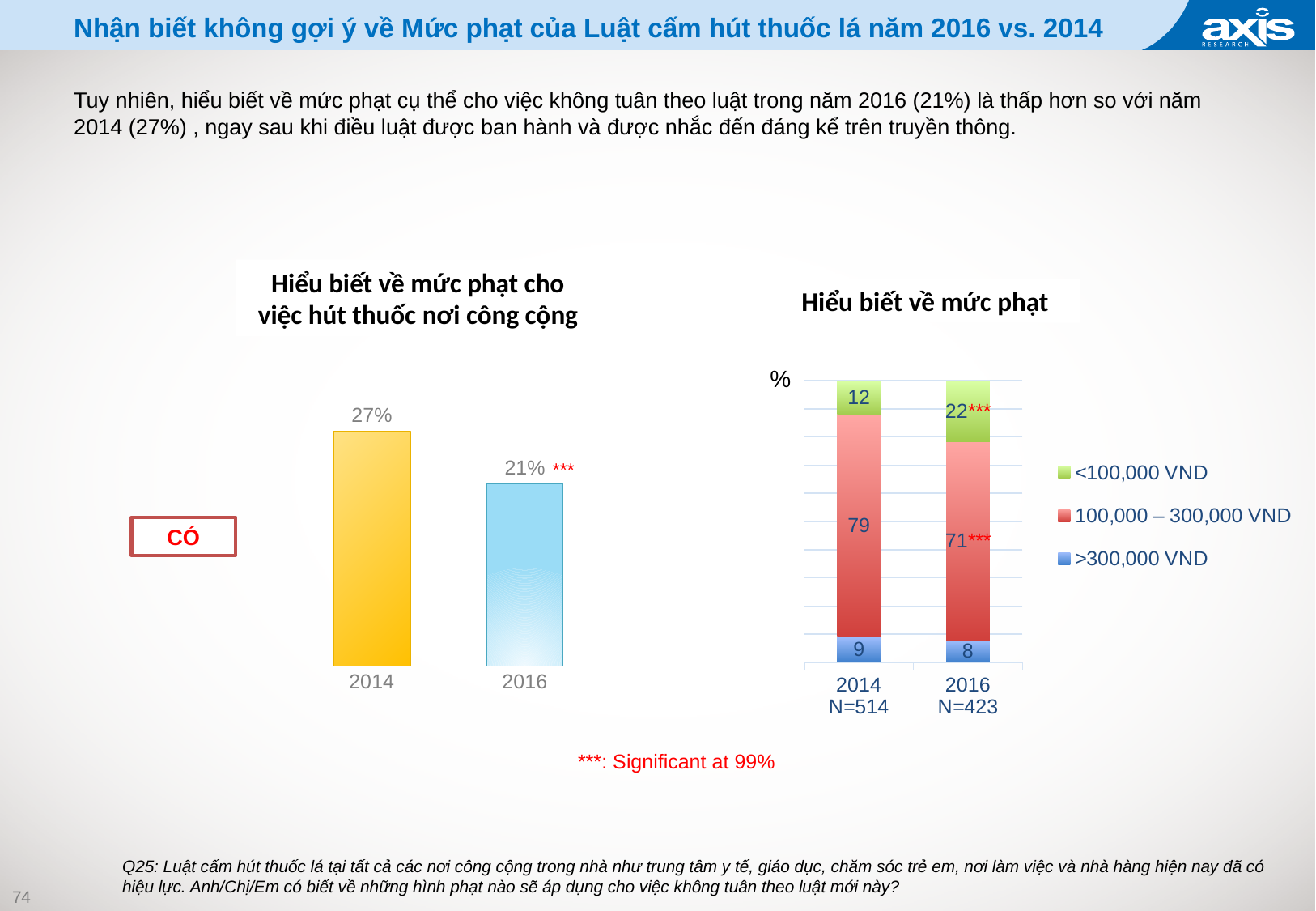
In the chart titled "Hiểu biết về mức phạt cho việc hút thuốc nơi công cộng", what is the difference between the 2014 and 2016 values? 6% In the chart titled "Hiểu biết về mức phạt", what is the value for ">300,000 VND" in 2016? 8 In the chart titled "Hiểu biết về mức phạt", which is larger: the "<100,000 VND" value in 2014 or in 2016? 2016 In the chart titled "Hiểu biết về mức phạt cho việc hút thuốc nơi công cộng", what is the value for 2014? 27% In the chart titled "Hiểu biết về mức phạt", what is the difference between the "100,000 – 300,000 VND" values for 2014 and 2016? 8 In the chart titled "Hiểu biết về mức phạt cho việc hút thuốc nơi công cộng", what is the value for 2016? 21% In the chart titled "Hiểu biết về mức phạt", how many series does the legend list? 3 In the chart titled "Hiểu biết về mức phạt", what is the value for "100,000 – 300,000 VND" in 2014? 79 In the chart titled "Hiểu biết về mức phạt", what is the sample size (N) shown for 2016? N=423 In the chart titled "Hiểu biết về mức phạt cho việc hút thuốc nơi công cộng", what kind of chart is shown? Bar chart In the chart titled "Hiểu biết về mức phạt", what is the value for "<100,000 VND" in 2016? 22 In the chart titled "Hiểu biết về mức phạt cho việc hút thuốc nơi công cộng", which year has the higher value? 2014